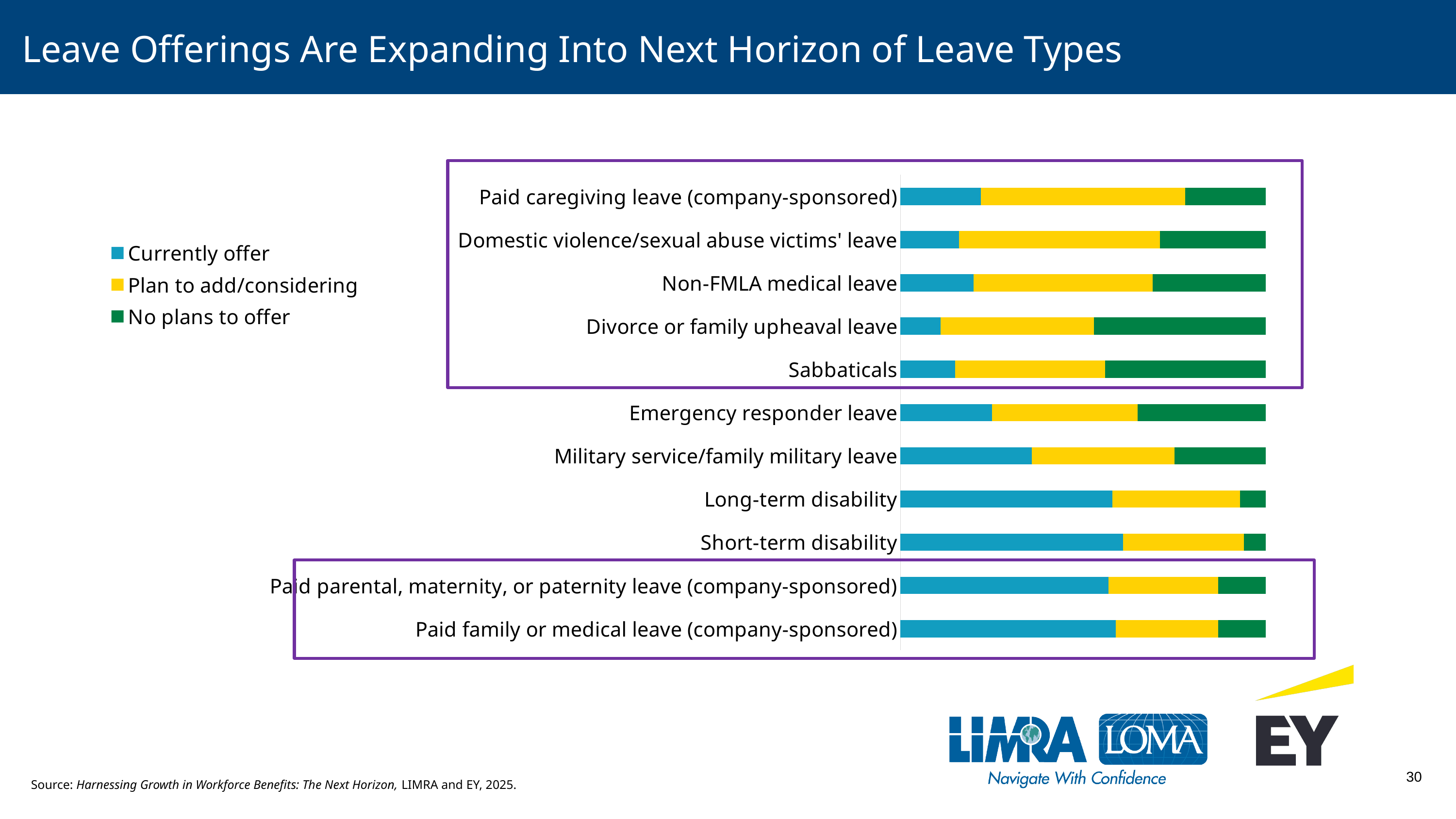
What are the three series listed in the legend? Currently offer, Plan to add/considering, No plans to offer What is the title of the slide containing the chart? Leave Offerings Are Expanding Into Next Horizon of Leave Types Which has the larger 'Currently offer' segment: Short-term disability or Paid caregiving leave (company-sponsored)? Short-term disability How many leave types (categories) are plotted in the chart? 11 Which has the larger 'No plans to offer' segment: Sabbaticals or Short-term disability? Sabbaticals Which has the larger 'Currently offer' segment: Long-term disability or Emergency responder leave? Long-term disability How many series does the chart's legend list? 3 What kind of chart is shown on the slide? Stacked bar chart